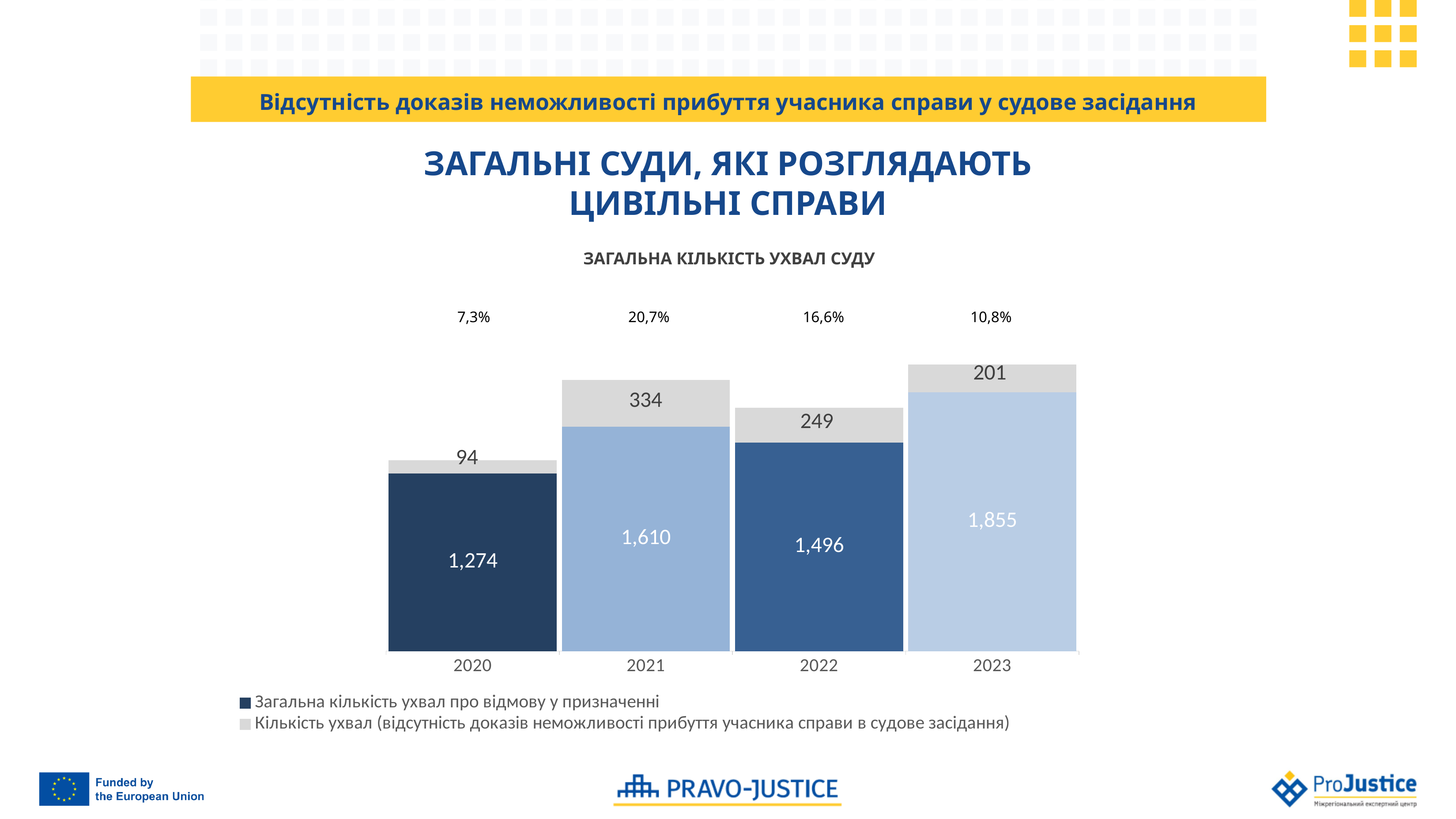
How many series does the legend list? 2 Which is larger: the 'Кількість ухвал (відсутність доказів неможливості прибуття учасника справи в судове засідання)' value for 2021 or for 2022? 2021 Which year has the highest value for 'Загальна кількість ухвал про відмову у призначенні'? 2023 What percentage is shown above the bar for 2022? 16,6% What is the total of the stacked bar for 2023? 2,056 What is the total of the stacked bar for 2020? 1,368 What is the value of 'Загальна кількість ухвал про відмову у призначенні' for 2021? 1,610 Which year has the lowest value for 'Кількість ухвал (відсутність доказів неможливості прибуття учасника справи в судове засідання)'? 2020 What is the value of 'Кількість ухвал (відсутність доказів неможливості прибуття учасника справи в судове засідання)' for 2023? 201 What type of chart is shown on the slide? Stacked bar chart How many years are shown on the x axis? 4 What is the difference between the 'Загальна кількість ухвал про відмову у призначенні' values for 2023 and 2020? 581